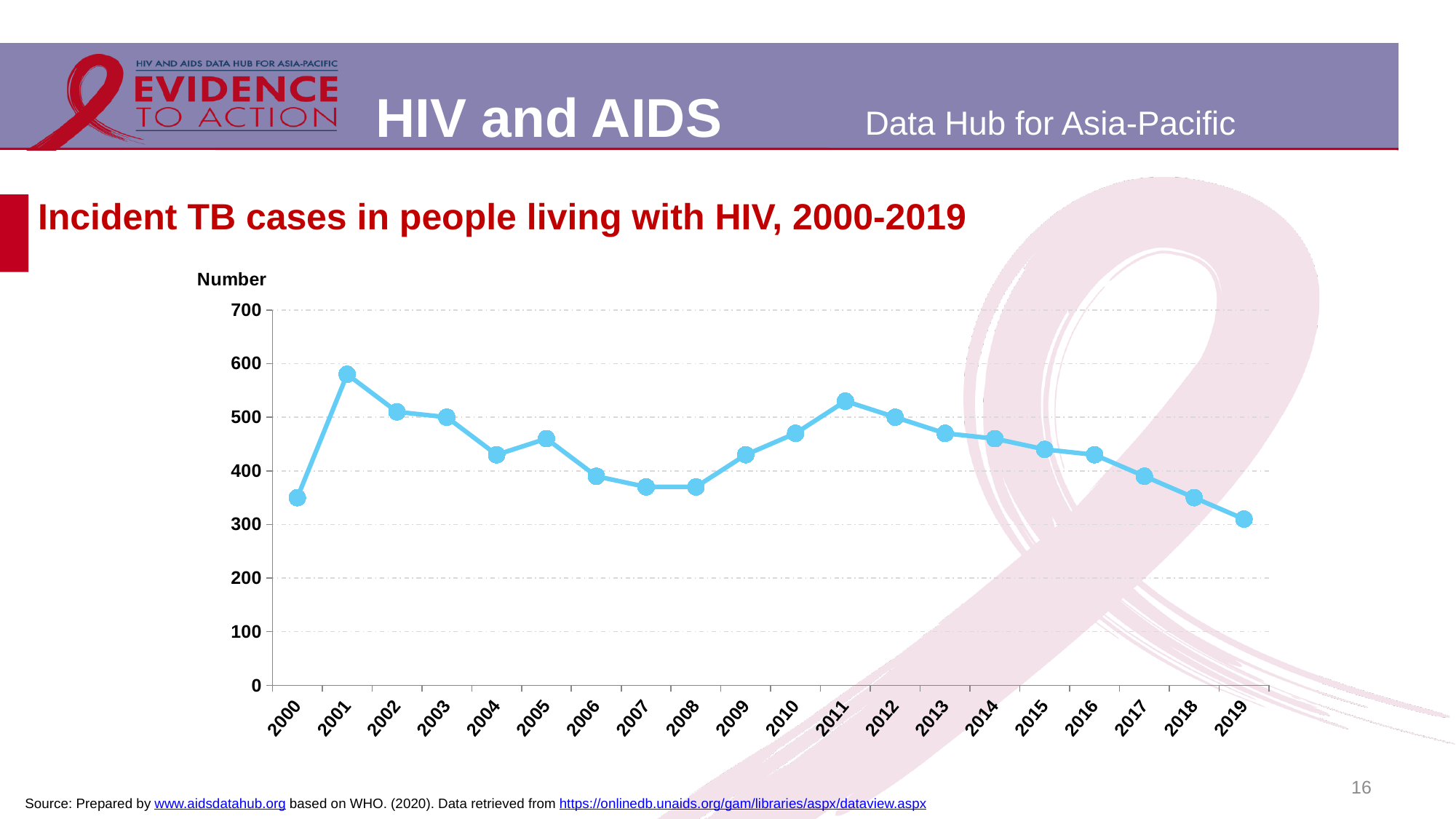
Is the value for 2011 greater or less than 500? greater In which year is the number of incident TB cases in people living with HIV highest? 2001 How many years are plotted on the x axis of the chart? 20 Is the value for 2000 greater or less than 400? less In which year is the number of incident TB cases in people living with HIV lowest? 2019 What kind of chart is shown on the slide? line chart Is the value for 2001 greater or less than 500? greater What is the label on the vertical axis of the chart? Number Which year has a higher value, 2001 or 2011? 2001 Which year has a higher value, 2007 or 2009? 2009 Do the values rise or fall from 2011 to 2019? fall